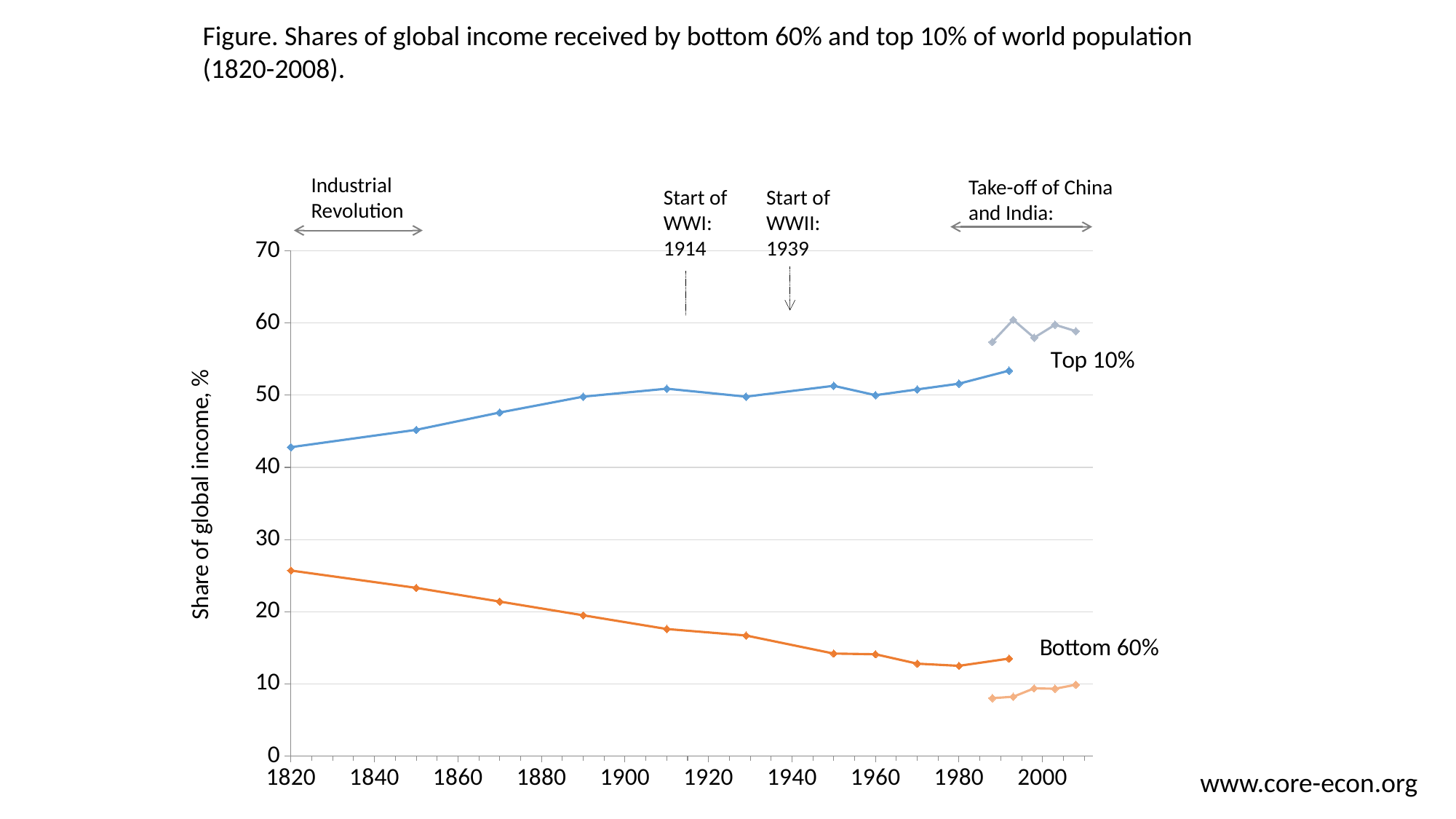
Which series has the larger value in 1900, Top 10% or Bottom 60%? Top 10% What is the label on the vertical axis? Share of global income, % What kind of chart is shown on the slide? line chart Is the Top 10% share in 1990 greater or less than 50? greater Is the Top 10% share in 1820 greater or less than 40? greater Is the Top 10% share in 1850 greater or less than 50? less According to the annotation, in what year did WWI start? 1914 How does the Bottom 60% share change from 1820 to 1980 along the x axis? falls How does the Top 10% share change from 1820 to 1990 along the x axis? rises